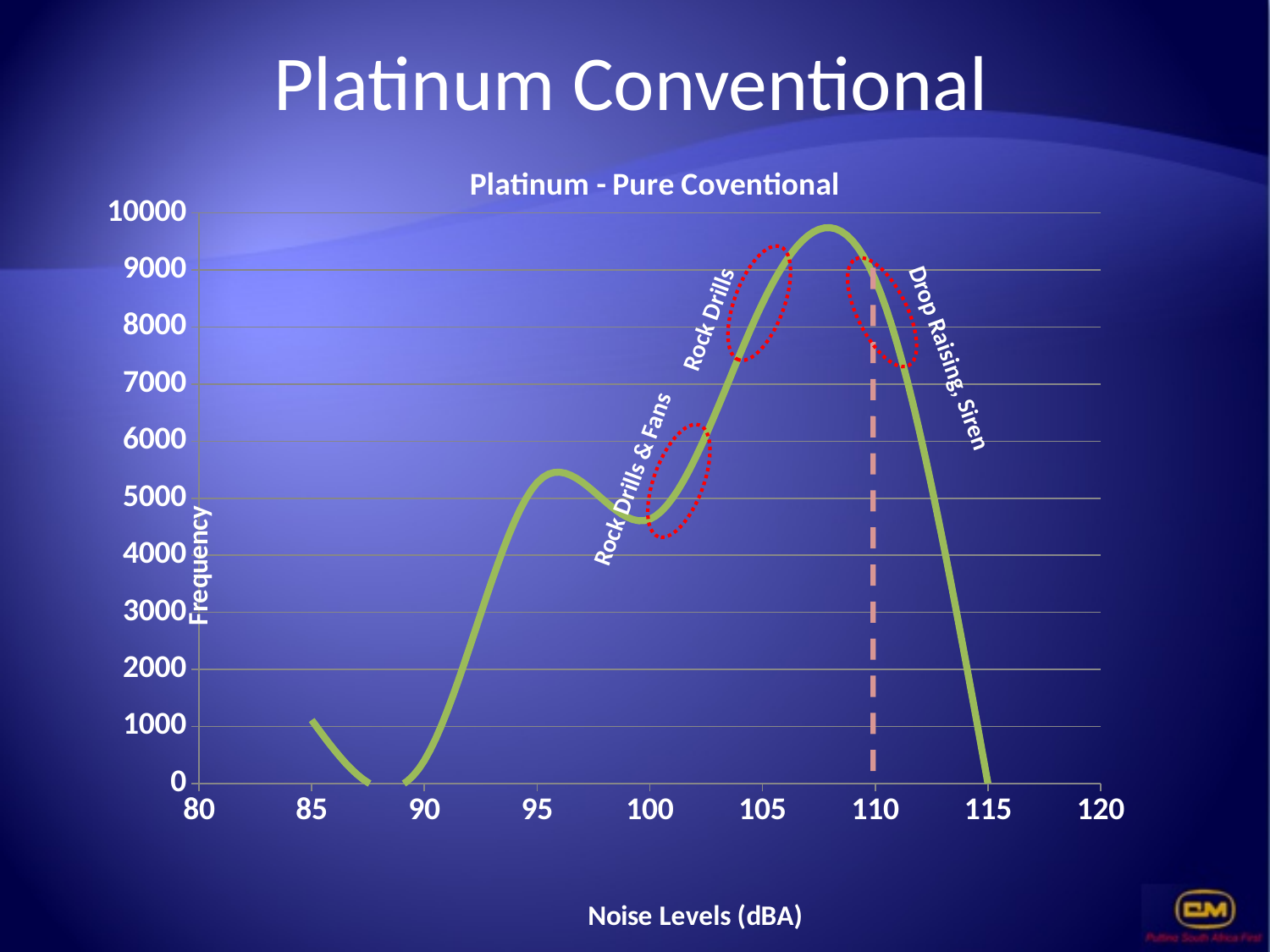
Is the value at 90 dBA greater or less than 1000? less Is the value at 105 dBA greater or less than 8000? greater Is the value at 115 dBA greater or less than 1000? less Does the curve rise or fall between 110 and 115 dBA? fall Does the curve rise or fall between 90 and 95 dBA? rise Does the curve rise or fall between 100 and 105 dBA? rise What kind of chart is shown on the slide? line chart What is the x-axis title of the chart? Noise Levels (dBA) What is the title of the chart? Platinum - Pure Coventional Is the value at 105 dBA larger or smaller than the value at 95 dBA? larger